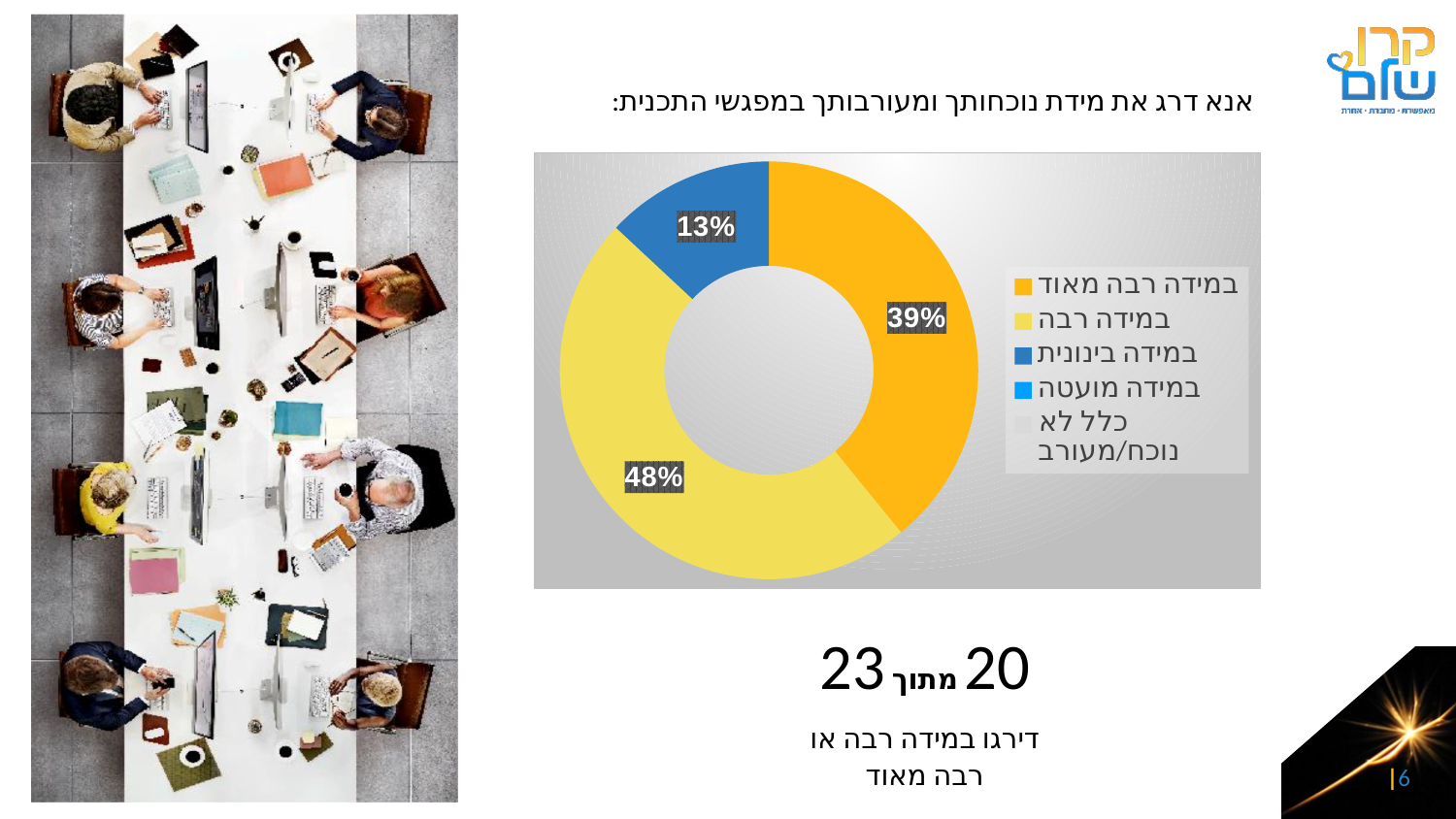
What share of respondents answered "במידה רבה" in the chart? 48% How many slices with data labels are shown in the chart? 3 Which category has the largest slice in the chart? במידה רבה What share of respondents answered "במידה בינונית" in the chart? 13% Which is larger: the "במידה רבה מאוד" slice or the "במידה בינונית" slice? במידה רבה מאוד How many entries does the chart's legend list? 5 What kind of chart is shown on the slide? Pie (donut) chart What is the difference in percentage points between the "במידה רבה" slice and the "במידה רבה מאוד" slice? 9 What is the combined share of the "במידה רבה מאוד" and "במידה רבה" slices? 87% Which of the labelled slices is the smallest in the chart? במידה בינונית What colour is the "במידה בינונית" slice in the chart? Blue What share of respondents answered "במידה רבה מאוד" in the chart? 39%